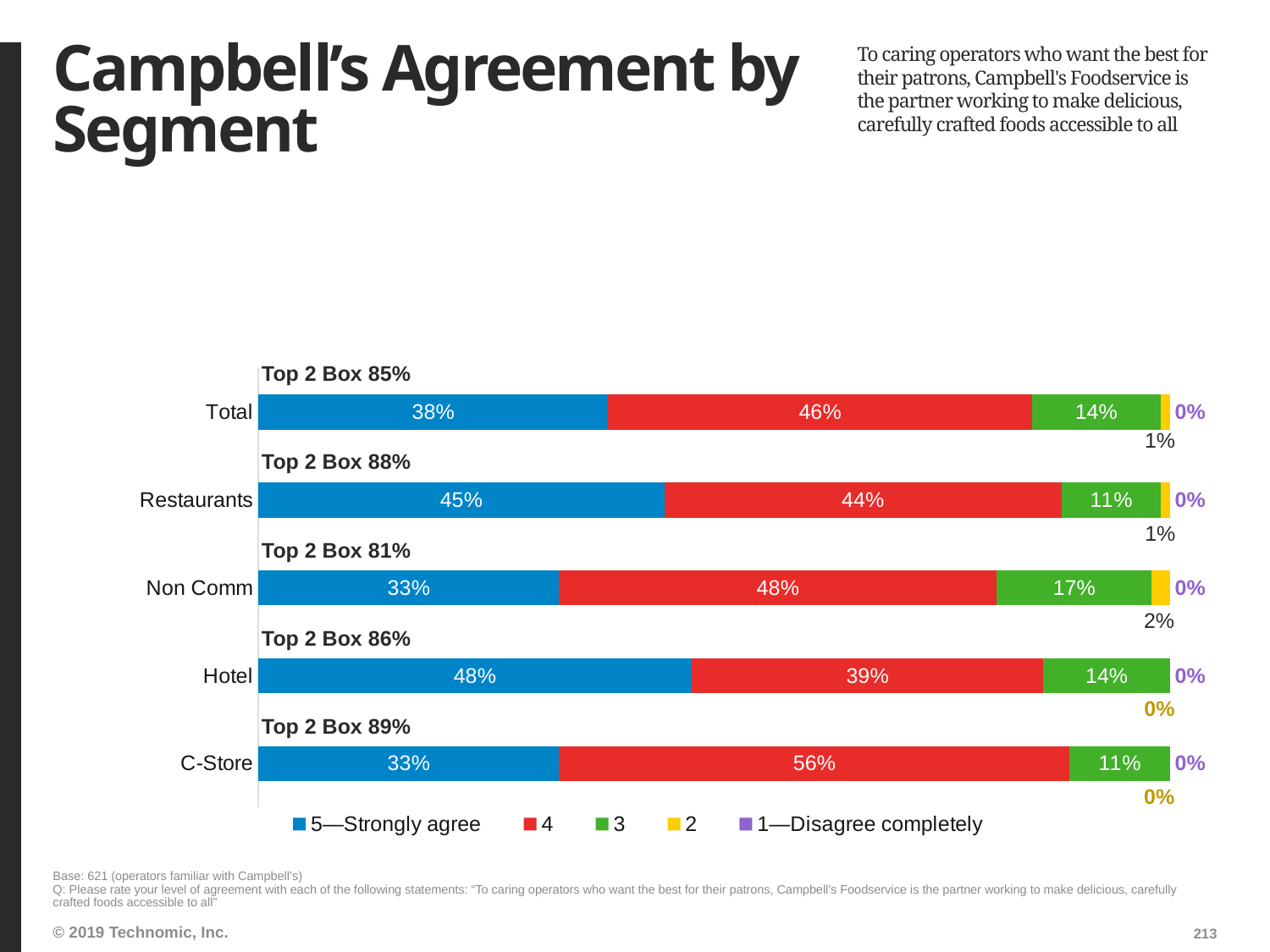
What is the "4" rating share for C-Store? 56% Which segment has the lowest Top 2 Box value? Non Comm How many series does the legend list? 5 Which segment has the highest "5—Strongly agree" share? Hotel Which legend entry is shown in blue? 5—Strongly agree What is the "3" rating share for Non Comm? 17% What is the difference between the "4" rating share for C-Store and for Hotel? 17% How many segments are shown on the chart? 5 What percentage of Total respondents selected "5—Strongly agree"? 38% What kind of chart is shown on the slide? Stacked bar chart Which is larger: the "5—Strongly agree" share for Restaurants or for Non Comm? Restaurants What is the Top 2 Box value for Non Comm? Top 2 Box 81%